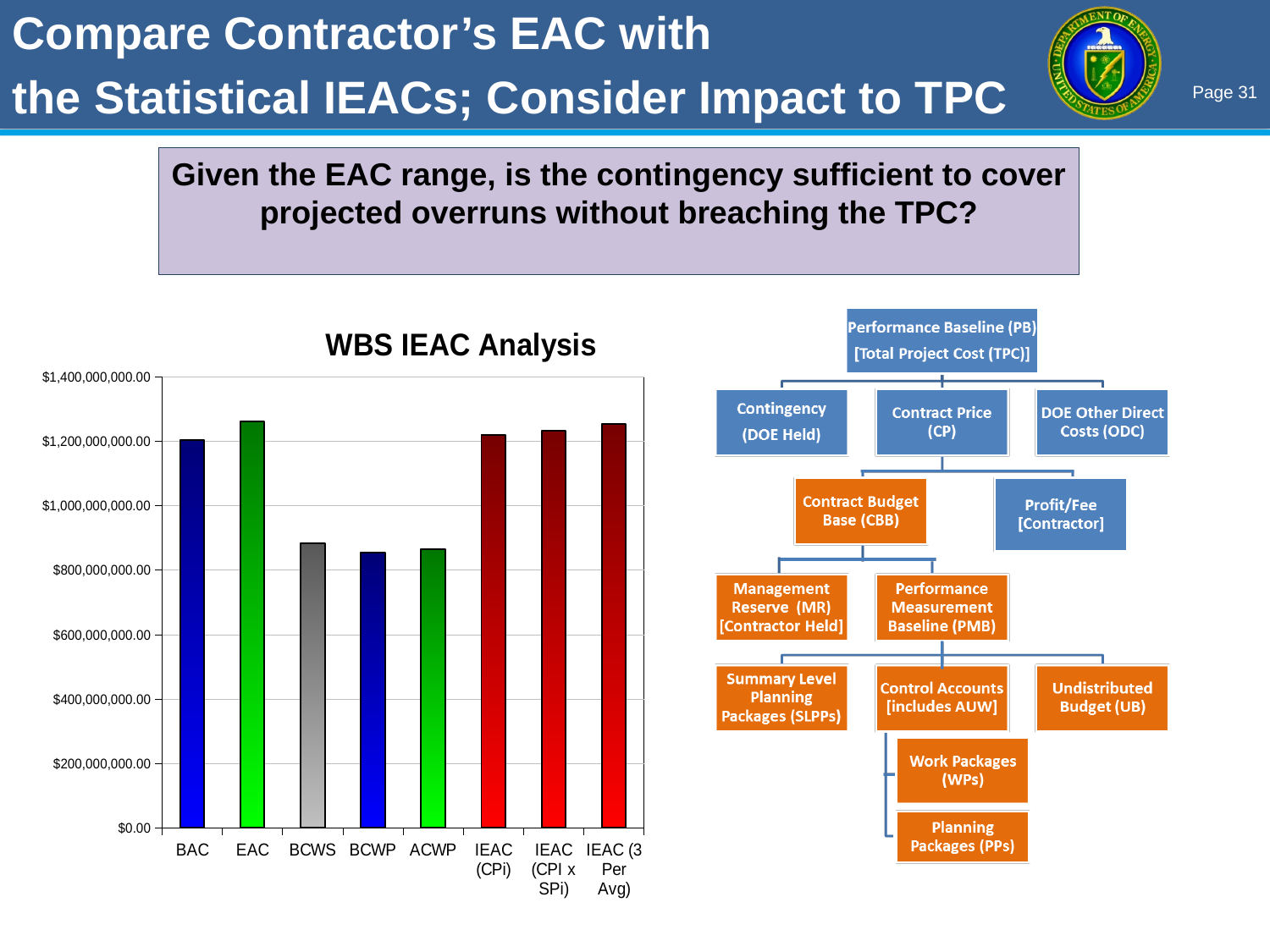
In the WBS IEAC Analysis chart, which is larger, EAC or BAC? EAC In the WBS IEAC Analysis chart, which is larger, BAC or BCWP? BAC How many categories are shown on the x axis of the WBS IEAC Analysis chart? 8 In the WBS IEAC Analysis chart, is the value for BAC greater or less than $1,000,000,000.00? greater In the WBS IEAC Analysis chart, is the value for BCWP greater or less than $800,000,000.00? greater In the WBS IEAC Analysis chart, is the value for BCWS greater or less than $1,000,000,000.00? less What is the title of the chart on the slide? WBS IEAC Analysis In the WBS IEAC Analysis chart, which is larger, EAC or BCWS? EAC What kind of chart is the WBS IEAC Analysis chart? bar chart In the WBS IEAC Analysis chart, what colour is the BCWS bar? gray